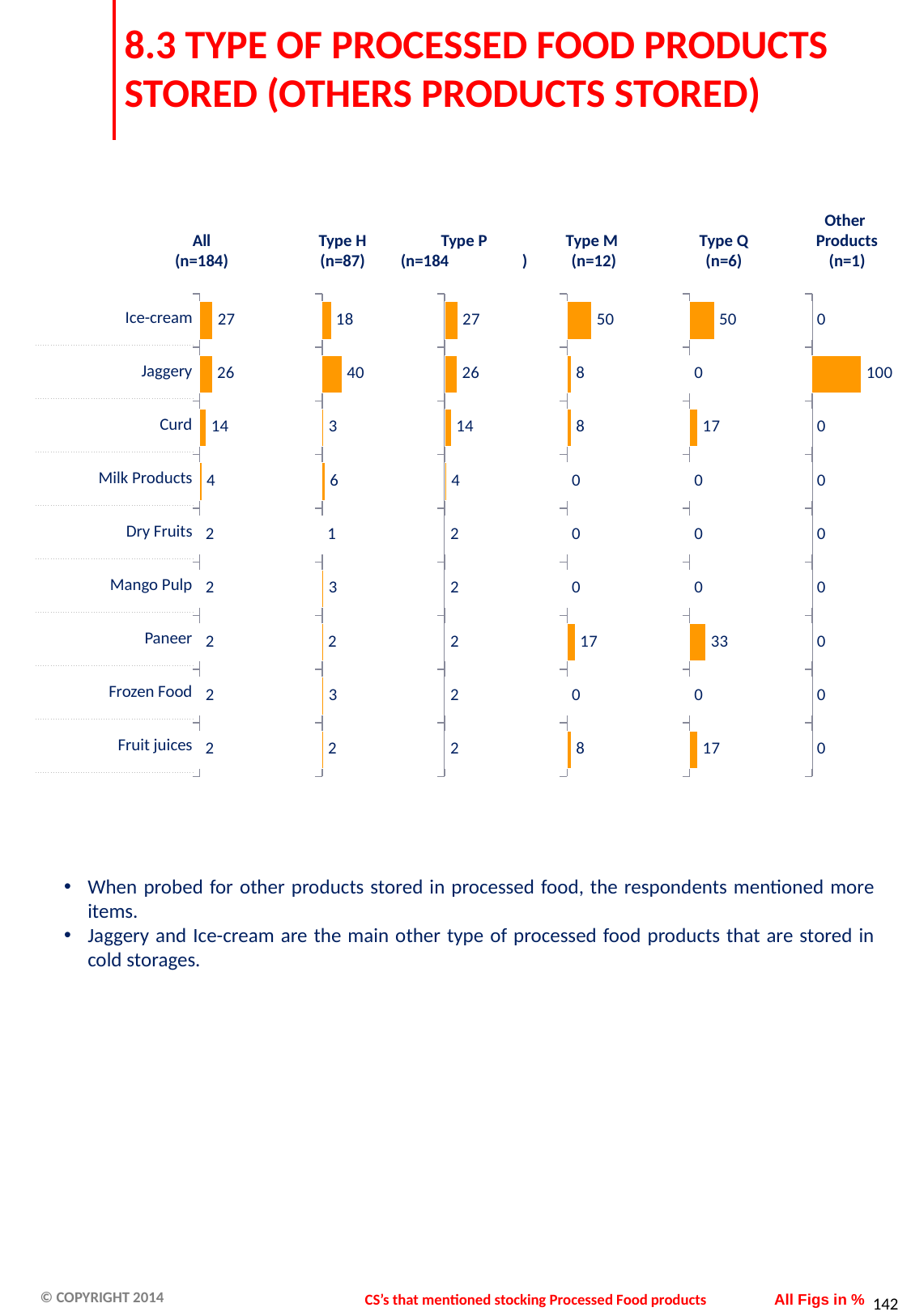
In the Type Q (n=6) chart, which is larger, the value for Paneer or the value for Curd? Paneer In the Type H (n=87) chart, which category has the lowest value? Dry Fruits In the Type Q (n=6) chart, which category has the highest value? Ice-cream In the Type M (n=12) chart, what is the value for Fruit juices? 8 In the Type M (n=12) chart, what is the value for Paneer? 17 In the Other Products (n=1) chart, what is the value for Jaggery? 100 How many categories are listed in the All (n=184) chart? 9 In the Type H (n=87) chart, what is the difference between the values for Jaggery and Ice-cream? 22 How many separate bar charts are shown on the slide? 6 In the Type H (n=87) chart, what is the value for Jaggery? 40 What kind of chart is used for the Type P (n=184) data? Bar chart In the All (n=184) chart, what is the value for Ice-cream? 27